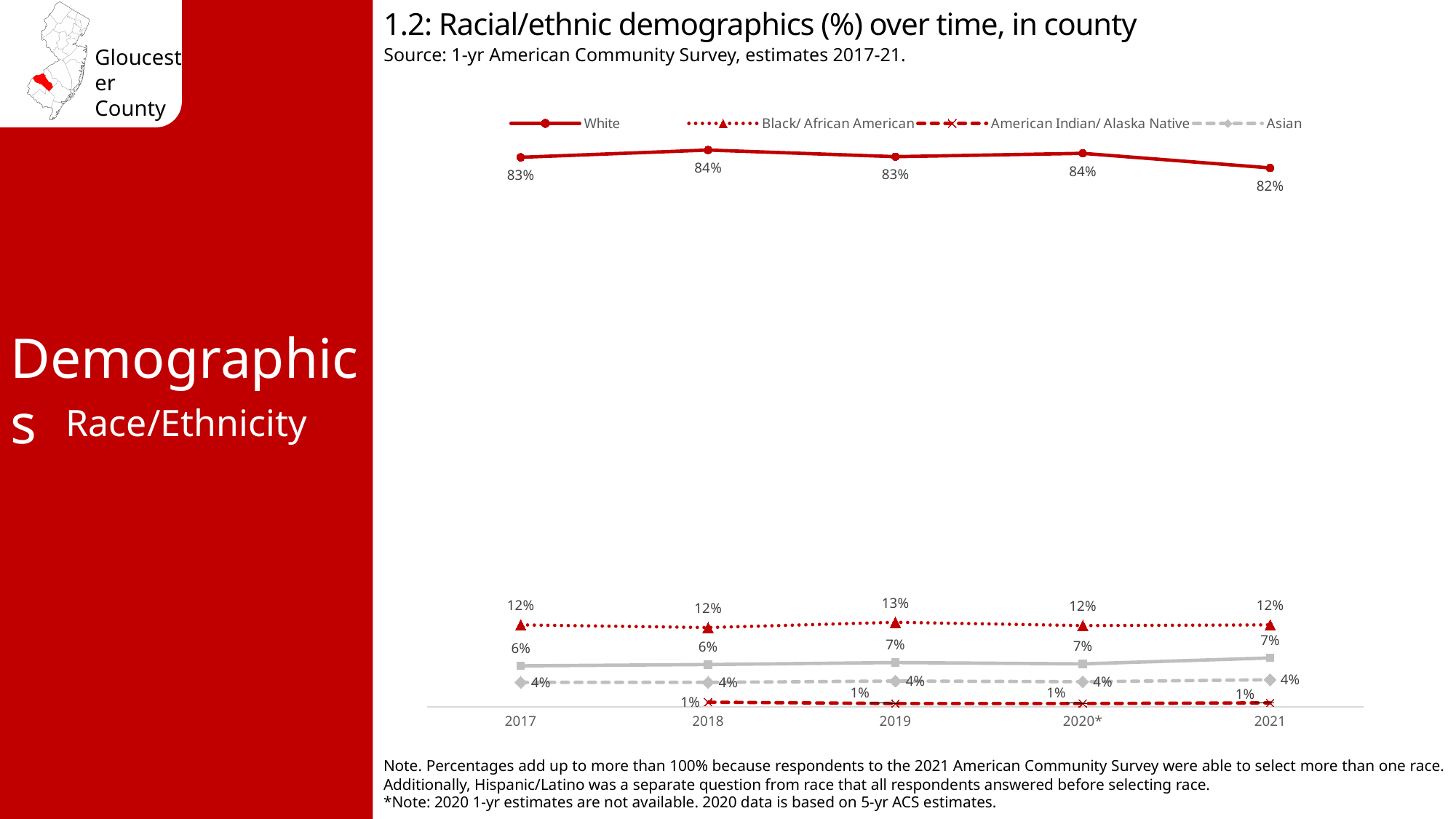
How many years are shown on the x axis? 5 In which year was the White percentage lowest? 2021 How many series does the legend list? 4 What is the source cited under the chart title? 1-yr American Community Survey, estimates 2017-21 In which year was the Black/ African American percentage highest? 2019 What is the difference between the White percentage in 2018 and in 2021? 2% What was the American Indian/ Alaska Native percentage in 2020*? 1% What was the White percentage in 2021? 82% Which was larger in 2021, the Black/ African American percentage or the Asian percentage? Black/ African American What was the Black/ African American percentage in 2019? 13% What was the Asian percentage in 2017? 4% What type of chart is shown on the slide? line chart